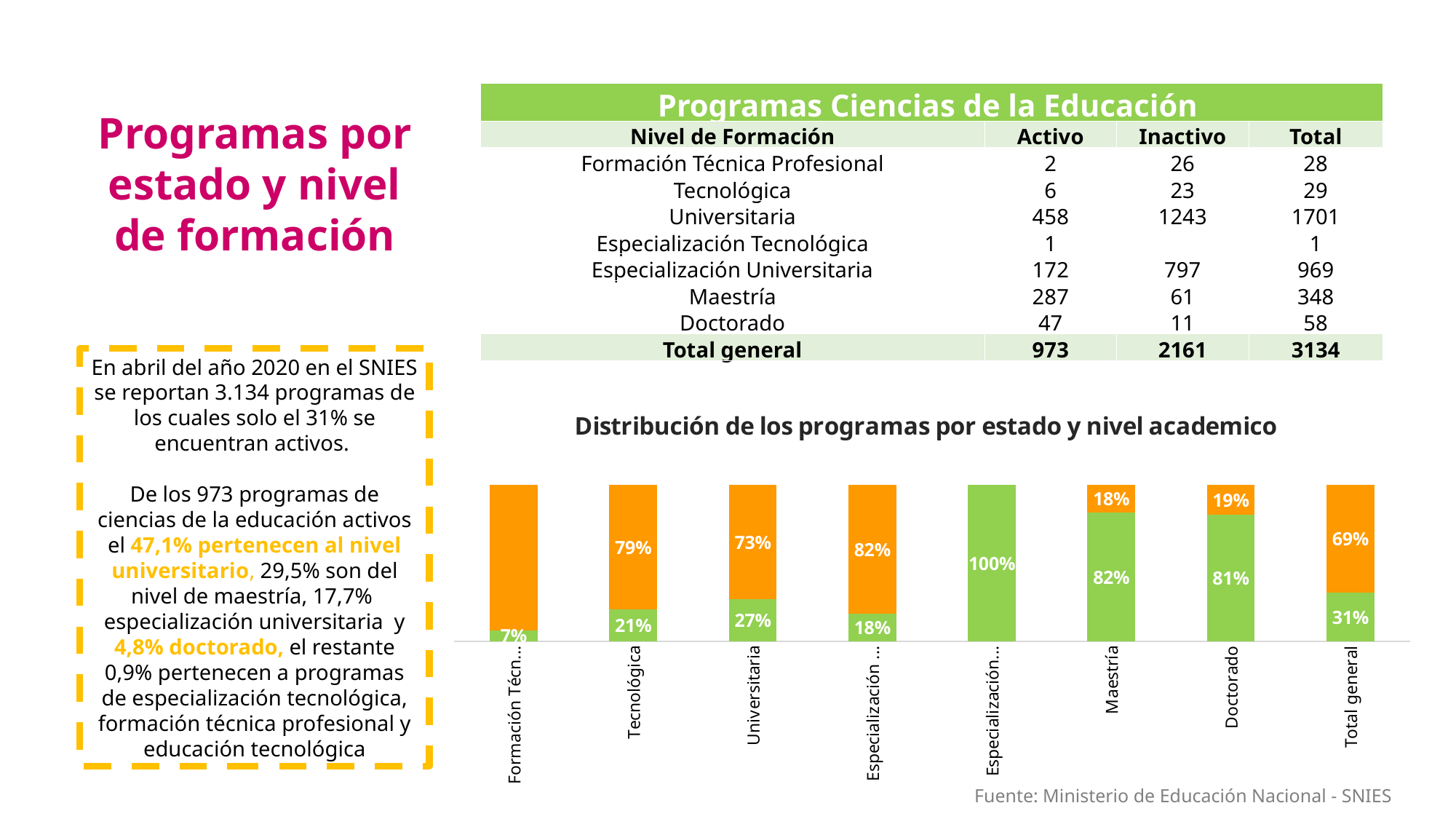
In the chart, what is the difference in percentage points between the orange and green segments of the Total general bar? 38 In the chart, what is the total of the two segments of the Tecnológica bar? 100% In the chart, what percentage is shown on the green segment of the Maestría bar? 82% In the chart, what percentage is shown on the fifth bar from the left, which is entirely green? 100% How many bars are plotted in the chart 'Distribución de los programas por estado y nivel academico'? 8 What kind of chart is shown under the title 'Distribución de los programas por estado y nivel academico'? Stacked bar chart In the chart, what percentage is shown on the green segment of the Total general bar? 31% In the chart, what percentage is shown on the green segment of the Tecnológica bar? 21% In the chart, what percentage is shown on the orange segment of the Universitaria bar? 73% In the chart, which has the larger orange segment: Tecnológica or Universitaria? Tecnológica What is the title of the chart on the slide? Distribución de los programas por estado y nivel academico In the chart, what percentage is shown on the orange segment of the Doctorado bar? 19%